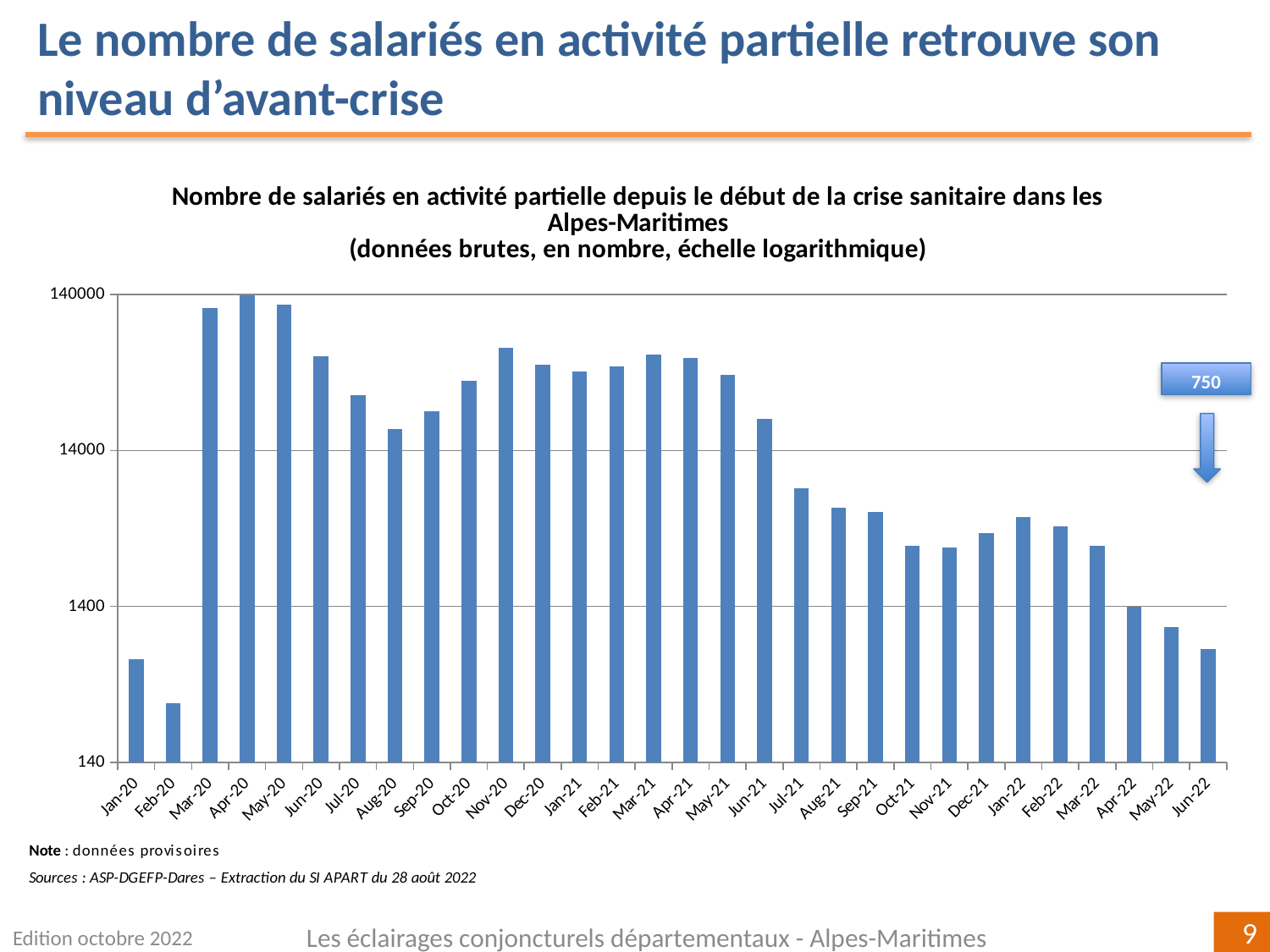
What type of scale does the chart's vertical axis use, according to the chart title? logarithmic (échelle logarithmique) Which is larger, the value for Nov-20 or the value for Jul-21? Nov-20 Is the value for Mar-20 greater or less than 14000? greater What kind of chart is shown on the slide? bar chart What value is shown in the callout box pointing to the last bar (Jun-22)? 750 Do the values generally rise or fall from Jun-21 to Jun-22? fall Which month has the lowest number of employees in partial activity? Feb-20 Which month has the highest number of employees in partial activity? Apr-20 Is the value for Jul-21 greater or less than 14000? less Is the value for Jan-20 greater or less than 1400? less How many months (bars) are plotted on the chart? 30